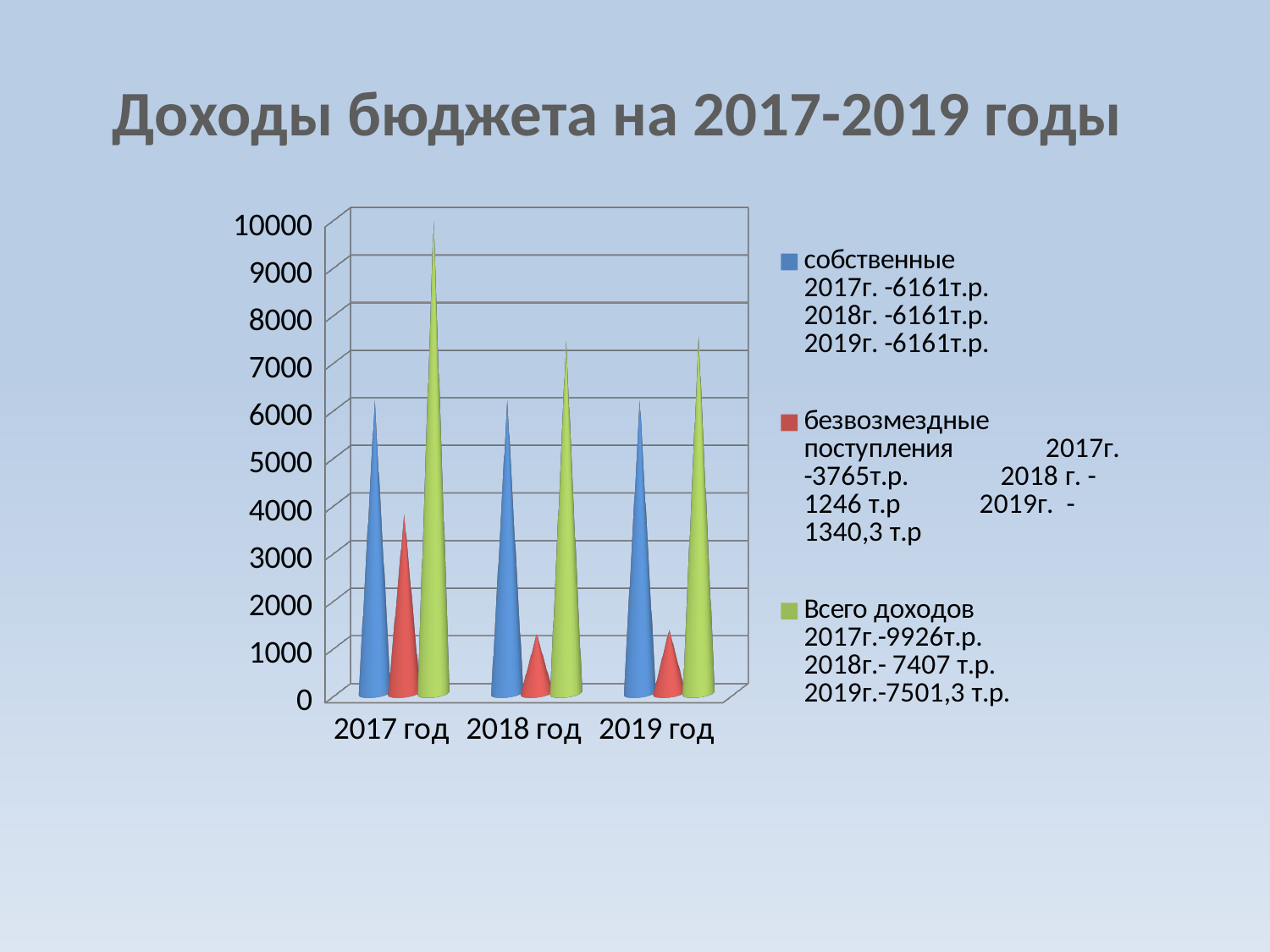
Is the value of Всего доходов for 2018 greater or less than 7000? greater Does Всего доходов rise or fall from 2017 to 2018? fall What is the value of безвозмездные поступления for 2017? 3765т.р. What is the value of Всего доходов for 2019? 7501,3 т.р. What is the value of собственные доходы for 2018? 6161т.р. What is the difference between Всего доходов in 2017 and 2018? 2519 т.р. In which year is безвозмездные поступления the lowest? 2018 In which year is Всего доходов the highest? 2017 What is the title of the chart? Доходы бюджета на 2017-2019 годы Which is larger: безвозмездные поступления in 2017 or in 2019? 2017 How many year categories are shown on the x axis? 3 How many series does the legend list? 3